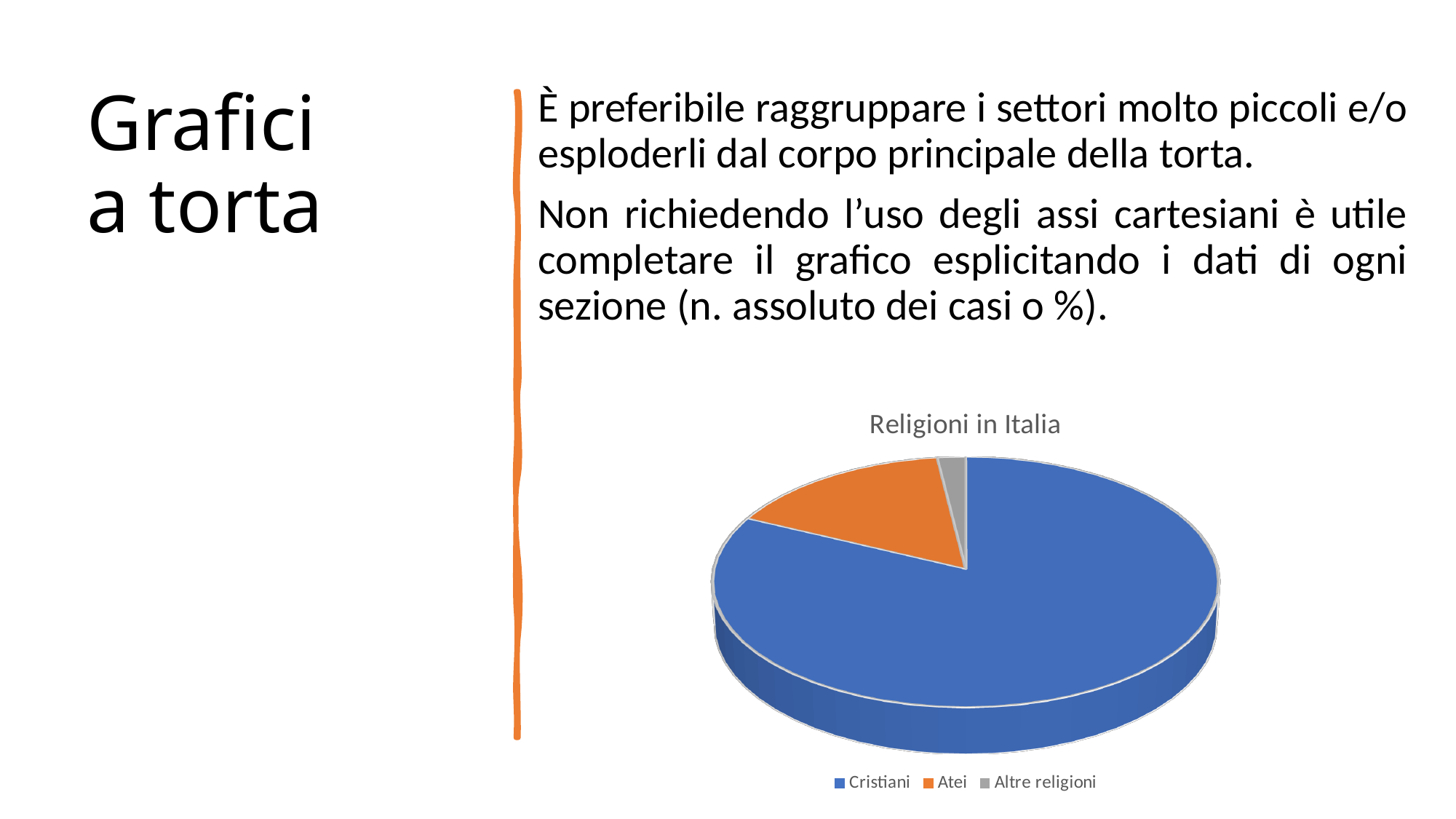
Which category has the largest slice of the pie? Cristiani Which slice is larger, Cristiani or Atei? Cristiani Which colour represents Atei in the pie chart? Orange What kind of chart is shown on the slide? Pie chart Which category has the smallest slice of the pie? Altre religioni How many categories does the pie chart show? 3 What is the title of the chart? Religioni in Italia How many entries does the legend list? 3 Which slice is larger, Atei or Altre religioni? Atei